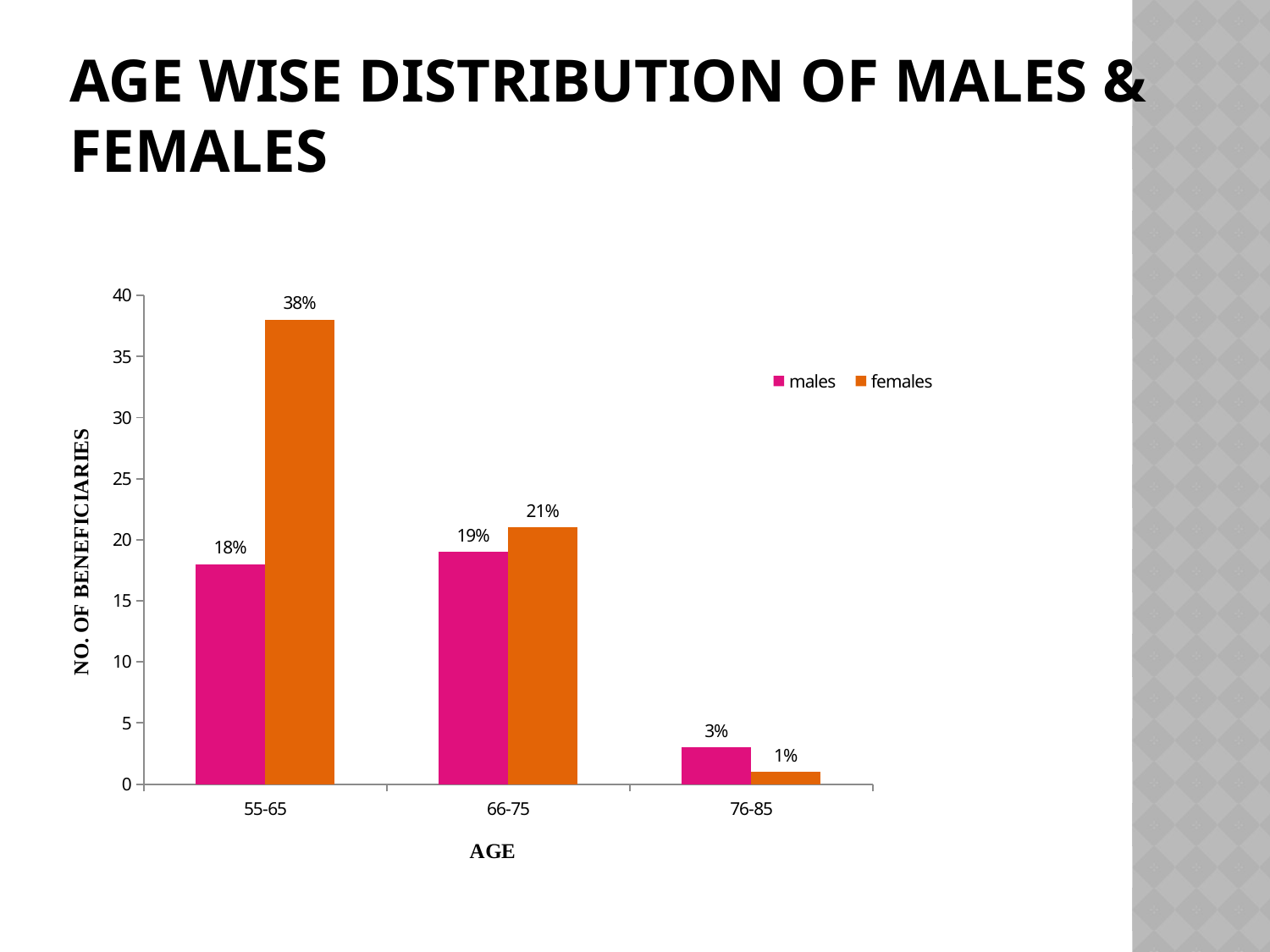
What is the data label for females in the 76-85 age group? 1% What is the data label for males in the 66-75 age group? 19% Is the value for females in the 55-65 age group greater or less than 35? greater What is the label of the y axis? NO. OF BENEFICIARIES What kind of chart is shown on the slide? bar chart Which age group has the highest value for females? 55-65 Which age group has the lowest value for males? 76-85 What is the data label for females in the 55-65 age group? 38% How many age groups are shown on the x axis? 3 What is the difference between the female and male labels in the 55-65 age group? 20% How many series does the legend list? 2 In the 76-85 age group, which is larger, males or females? males